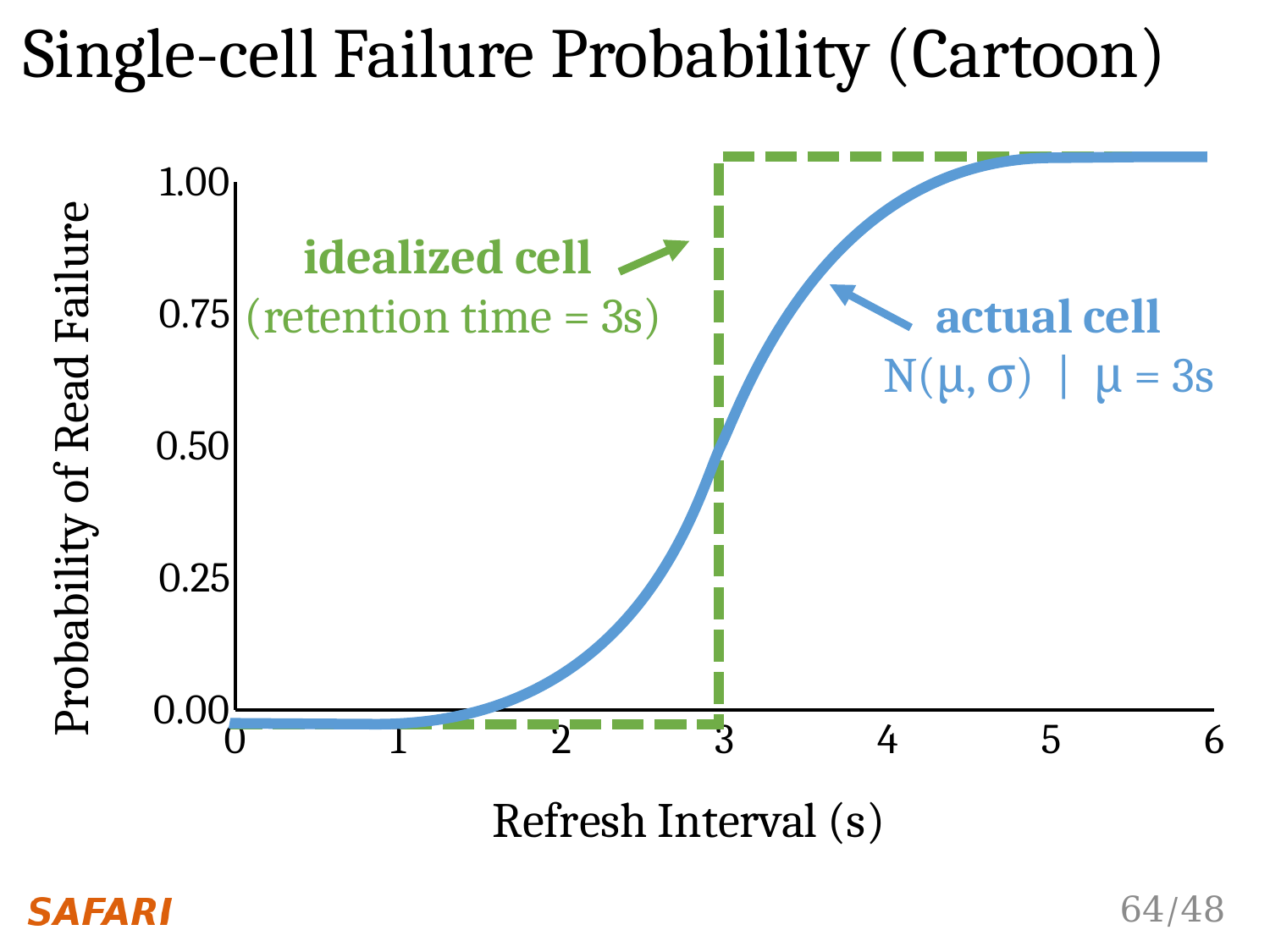
What is the value of μ given for the actual cell's distribution? 3s What retention time is given for the idealized cell? 3s Is the probability of read failure for the actual cell at a refresh interval of 4 s greater or less than 0.75? greater At a refresh interval of 4 s, which curve has the higher probability of read failure, the idealized cell or the actual cell? idealized cell Is the probability of read failure for the actual cell at a refresh interval of 2 s greater or less than 0.25? less What is the title of the chart on the slide? Single-cell Failure Probability (Cartoon) Is the probability of read failure for the idealized cell at a refresh interval of 4 s greater or less than 0.75? greater Does the probability of read failure for the actual cell rise or fall as the refresh interval increases? rise How many curves (series) are plotted on the chart? 2 What kind of chart is shown on the slide? line chart What is the label of the x axis? Refresh Interval (s)